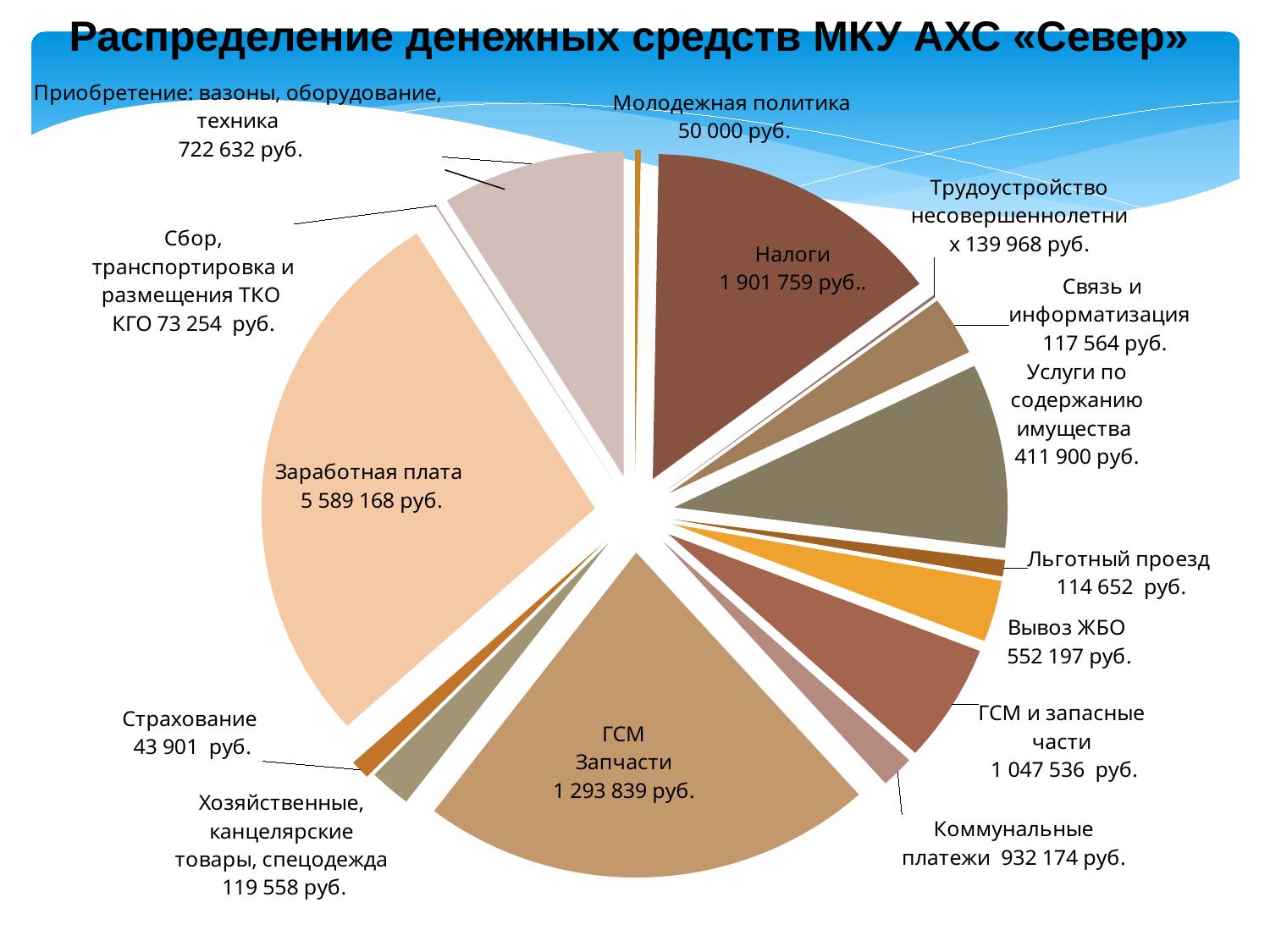
What is the value for Налоги? 1 901 759 руб. What is the value for Страхование? 43 901 руб. What is the value for Заработная плата? 5 589 168 руб. How many slices does the pie chart have? 15 What is the difference between Налоги and ГСМ и запасные части? 854 223 руб. What is the value for Коммунальные платежи? 932 174 руб. Which category has the largest slice? Заработная плата What kind of chart is shown on the slide? pie chart Which is larger: Коммунальные платежи or ГСМ Запчасти? ГСМ Запчасти What is the value for Вывоз ЖБО? 552 197 руб. Which category has the smallest value? Страхование What is the title of the chart? Распределение денежных средств МКУ АХС «Север»